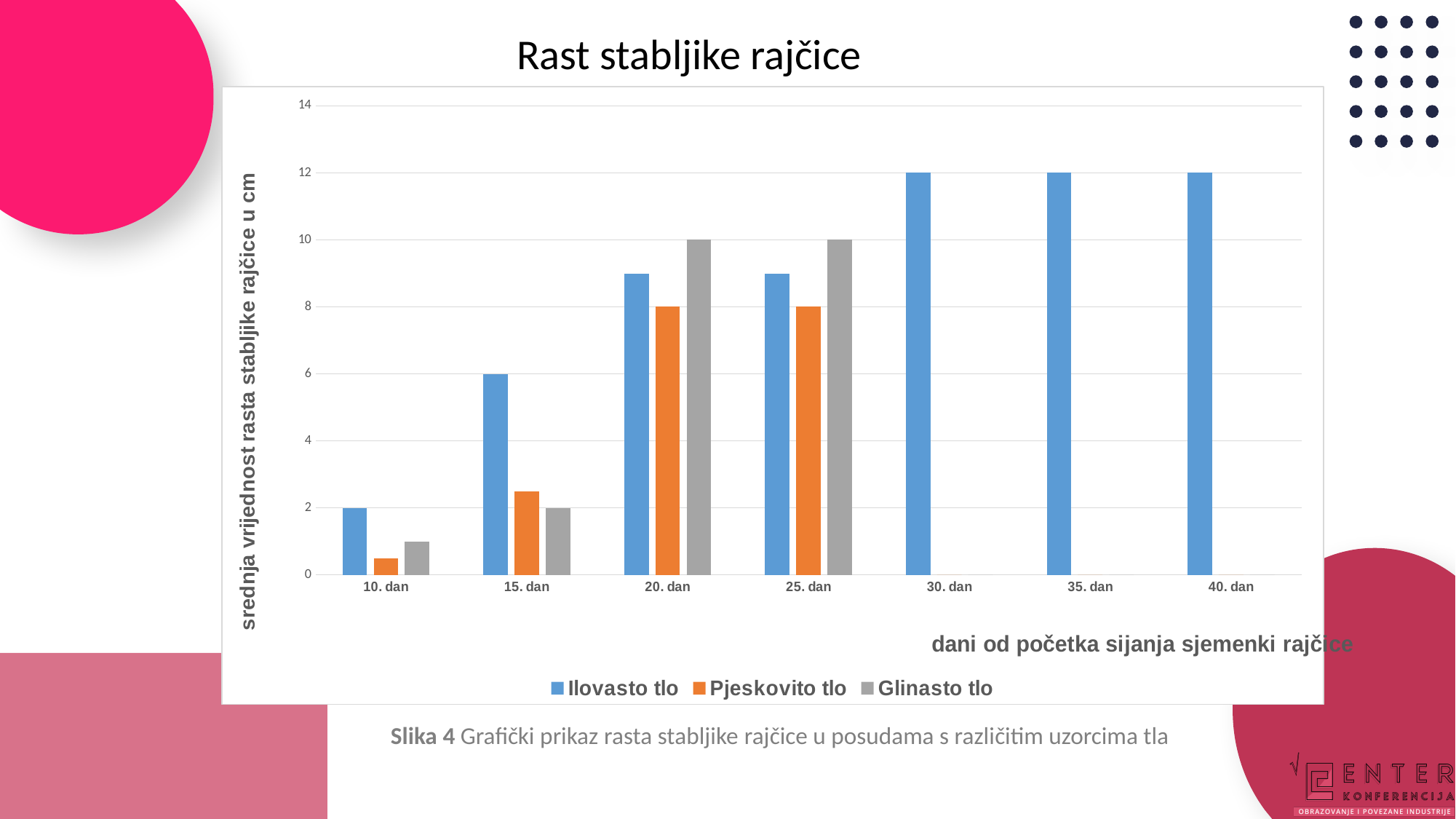
Is the value for Pjeskovito tlo at 10. dan greater or less than 2? less What is the value for Ilovasto tlo at 15. dan? 6 What is the value for Pjeskovito tlo at 25. dan? 8 How many day categories are shown on the x axis? 7 What is the value for Ilovasto tlo at 40. dan? 12 Which series has the highest value at 15. dan? Ilovasto tlo At 20. dan, which is larger: Glinasto tlo or Pjeskovito tlo? Glinasto tlo What is the difference between Glinasto tlo and Pjeskovito tlo at 20. dan? 2 How many series does the legend list? 3 What is the value for Glinasto tlo at 20. dan? 10 Is the value for Ilovasto tlo at 20. dan greater or less than 8? greater What kind of chart is shown on the slide? bar chart